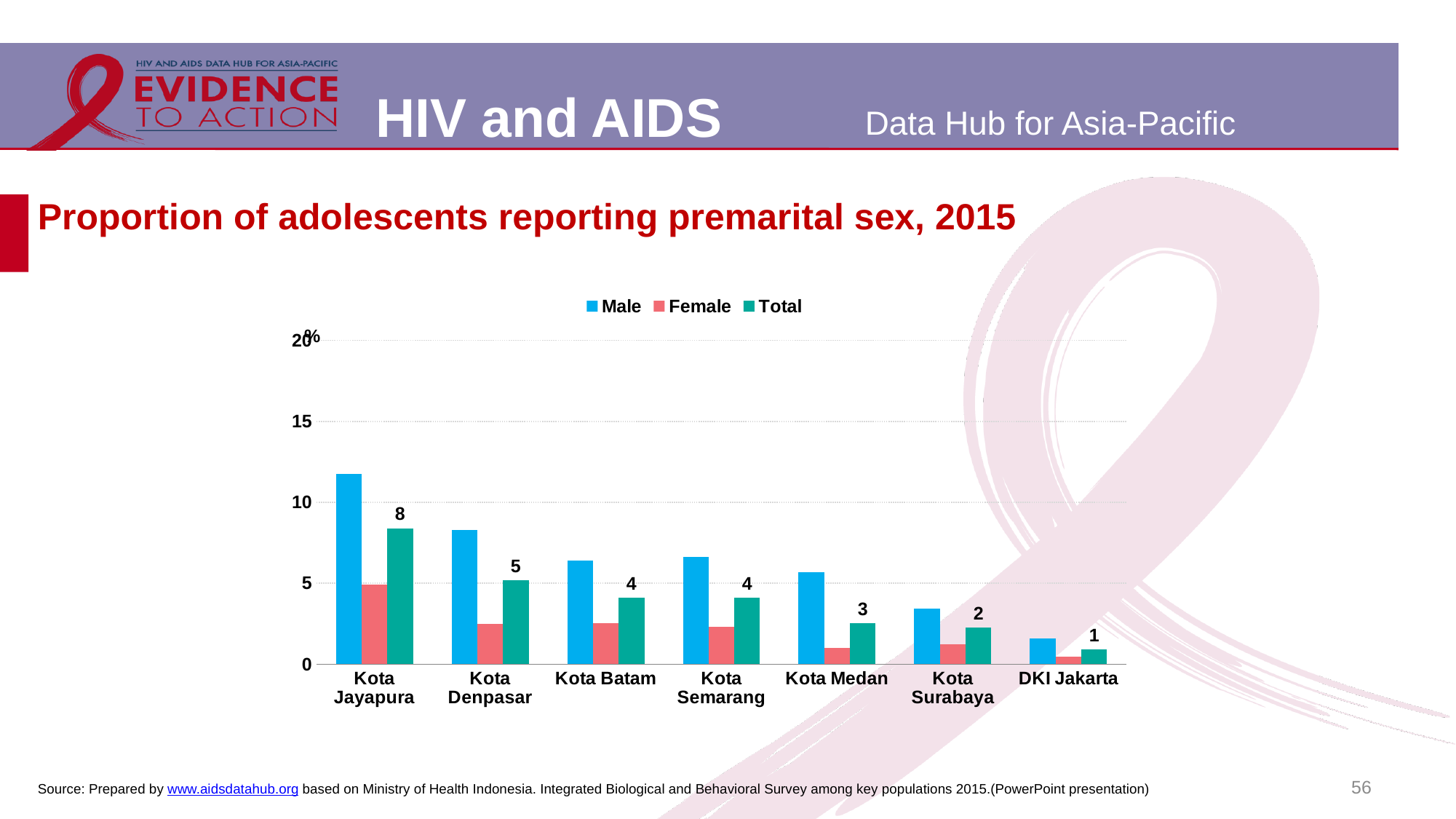
Which city has the highest Total value? Kota Jayapura Which city has the lowest Total value? DKI Jakarta How many series does the legend list? 3 What is the Total value for Kota Medan? 3 How many cities are shown on the x axis? 7 What is the Total value for Kota Denpasar? 5 Do the Total values rise or fall from left to right across the cities? fall What is the Total value for Kota Jayapura? 8 What is the Total value for DKI Jakarta? 1 What is the difference between the Total values for Kota Jayapura and Kota Denpasar? 3 Is the Male value for Kota Jayapura greater or less than 10? greater In Kota Jayapura, which is larger, the Male value or the Female value? Male